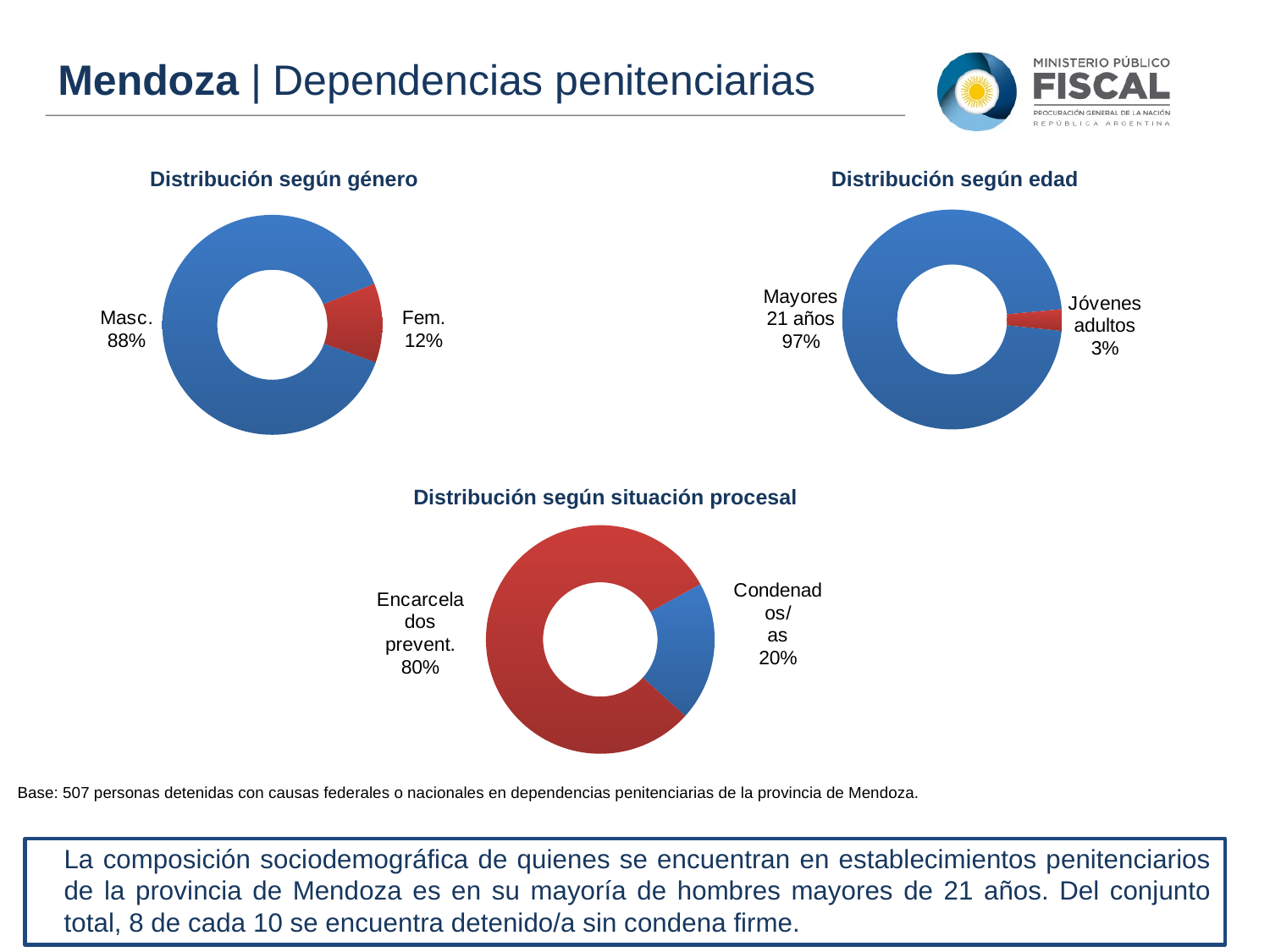
In the 'Distribución según género' chart, what percentage is labelled Fem.? 12% What kind of chart is 'Distribución según situación procesal'? Pie chart (doughnut) In the 'Distribución según edad' chart, what percentage is labelled Mayores 21 años? 97% In the 'Distribución según situación procesal' chart, what percentage is labelled Encarcelados prevent.? 80% In the 'Distribución según situación procesal' chart, what colour is the Encarcelados prevent. slice? Red In the 'Distribución según género' chart, which category has the largest share? Masc. In the 'Distribución según situación procesal' chart, what percentage is labelled Condenados/as? 20% In the 'Distribución según edad' chart, what percentage is labelled Jóvenes adultos? 3% In the 'Distribución según género' chart, what percentage is labelled Masc.? 88% In the 'Distribución según género' chart, how many categories are shown? 2 In the 'Distribución según edad' chart, which category has the smallest share? Jóvenes adultos In the 'Distribución según situación procesal' chart, what is the difference in percentage points between Encarcelados prevent. and Condenados/as? 60